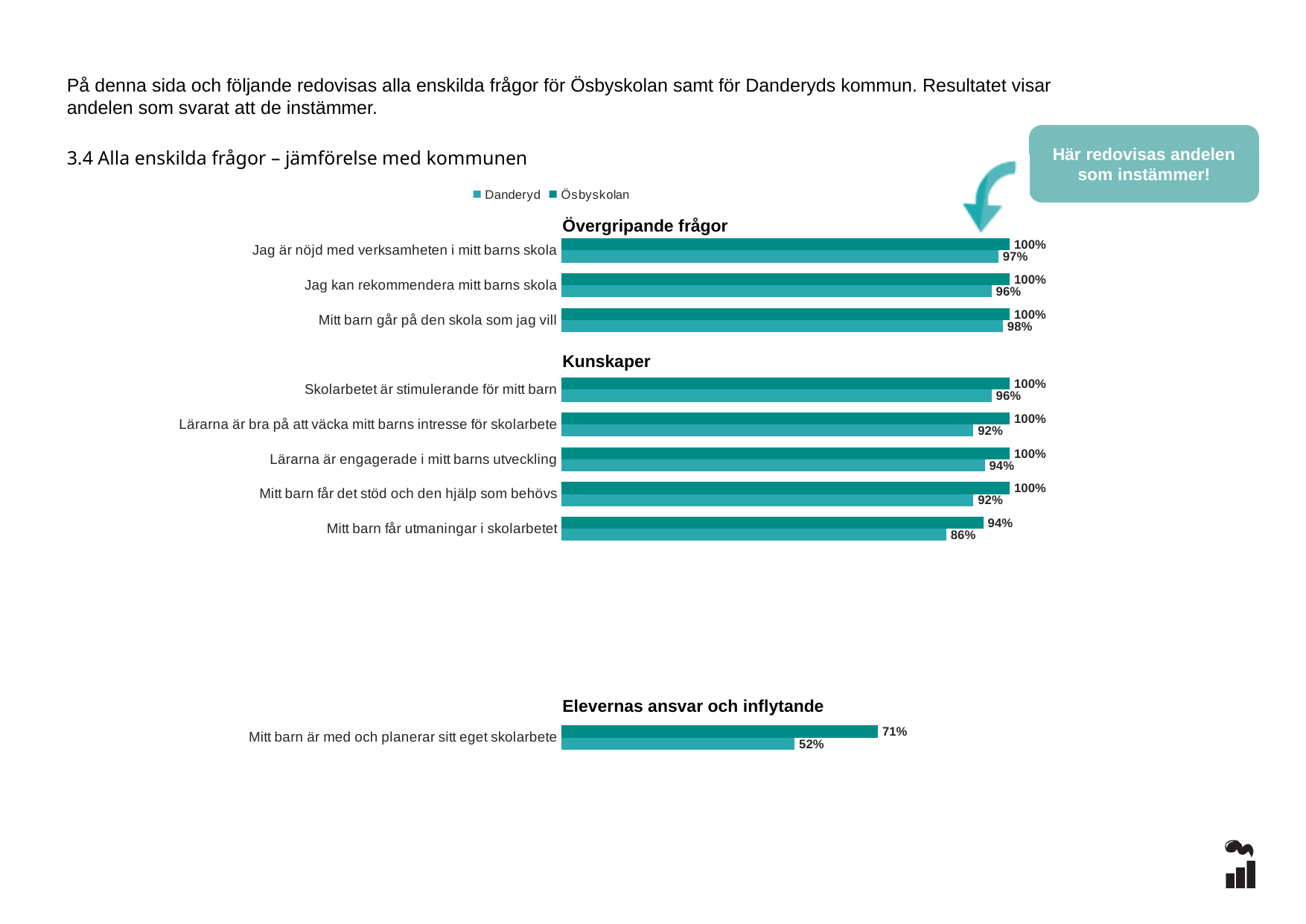
In the 'Kunskaper' chart, what is the difference between the Ösbyskolan and Danderyd values for 'Lärarna är bra på att väcka mitt barns intresse för skolarbete'? 8 percentage points In the 'Övergripande frågor' chart, what is the value for Ösbyskolan on 'Jag kan rekommendera mitt barns skola'? 100% In the 'Övergripande frågor' chart, which question has the highest Danderyd value? Mitt barn går på den skola som jag vill In the 'Elevernas ansvar och inflytande' chart, what is the difference between the Ösbyskolan and Danderyd values? 19 percentage points How many questions are plotted in the 'Kunskaper' chart? 5 In the 'Kunskaper' chart, what is the value for Danderyd on 'Mitt barn får utmaningar i skolarbetet'? 86% In the 'Kunskaper' chart, which is larger: the Danderyd value for 'Lärarna är engagerade i mitt barns utveckling' or for 'Mitt barn får det stöd och den hjälp som behövs'? Lärarna är engagerade i mitt barns utveckling What kind of chart is used on this slide? Bar chart In the 'Övergripande frågor' chart, what is the value for Danderyd on 'Jag är nöjd med verksamheten i mitt barns skola'? 97% In the 'Kunskaper' chart, which question has the lowest Danderyd value? Mitt barn får utmaningar i skolarbetet In the 'Elevernas ansvar och inflytande' chart, what is the value for Ösbyskolan on 'Mitt barn är med och planerar sitt eget skolarbete'? 71% How many series does the legend list? 2